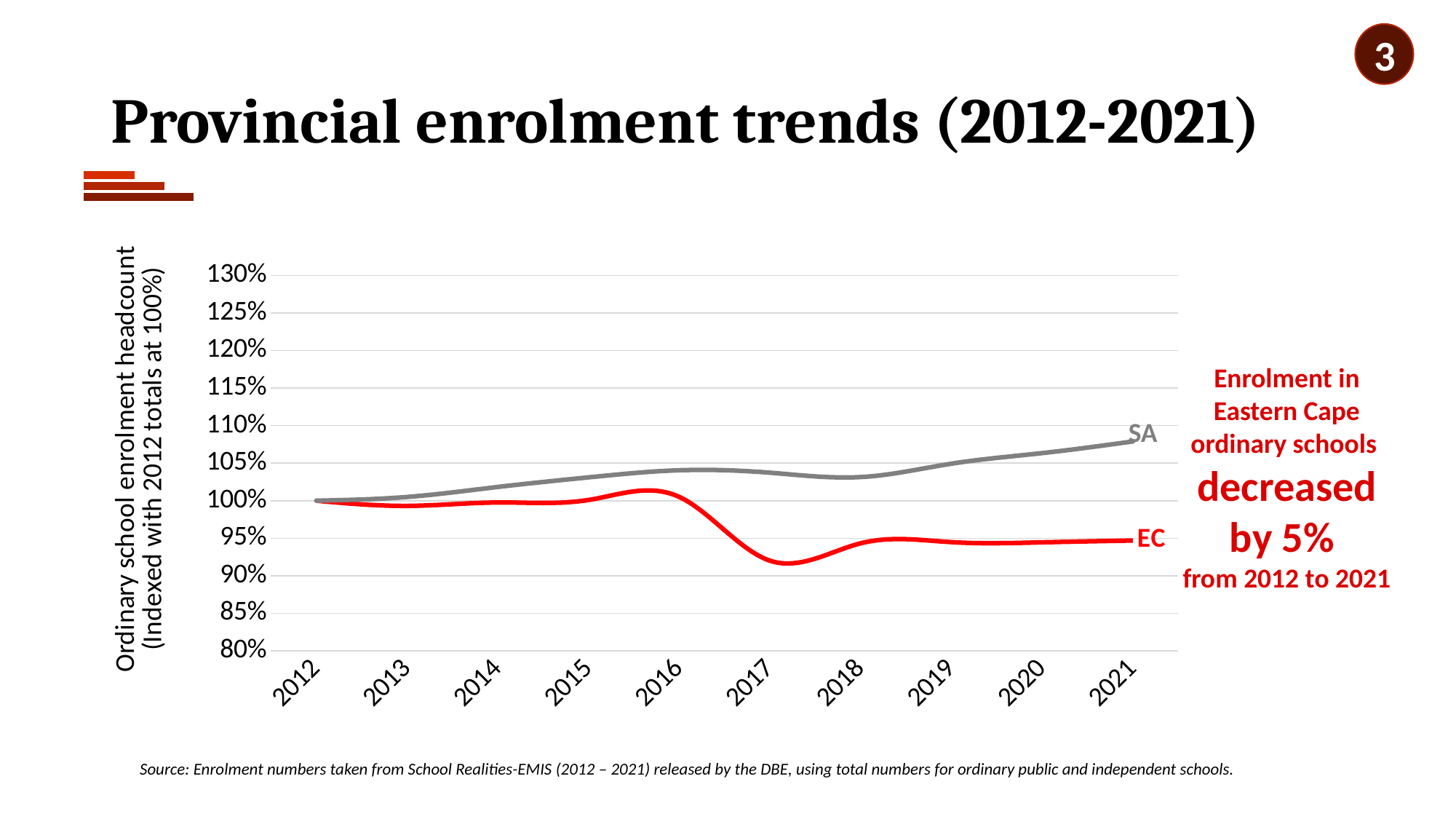
In which year does the SA series reach its highest value? 2021 What colour is the EC line on the chart? red Does the SA series rise or fall from 2012 to 2021? rise How many years are shown along the x axis of the chart? 10 How many series are plotted on the chart? 2 Is the value for SA in 2021 greater or less than 105%? greater Which series has the higher value in 2021, SA or EC? SA What kind of chart is shown on the slide? line chart In which year does the EC series reach its lowest value? 2017 Is the value for EC in 2021 greater or less than 100%? less What is the value of the SA series in 2012? 100% Is the value for EC in 2017 greater or less than 95%? less